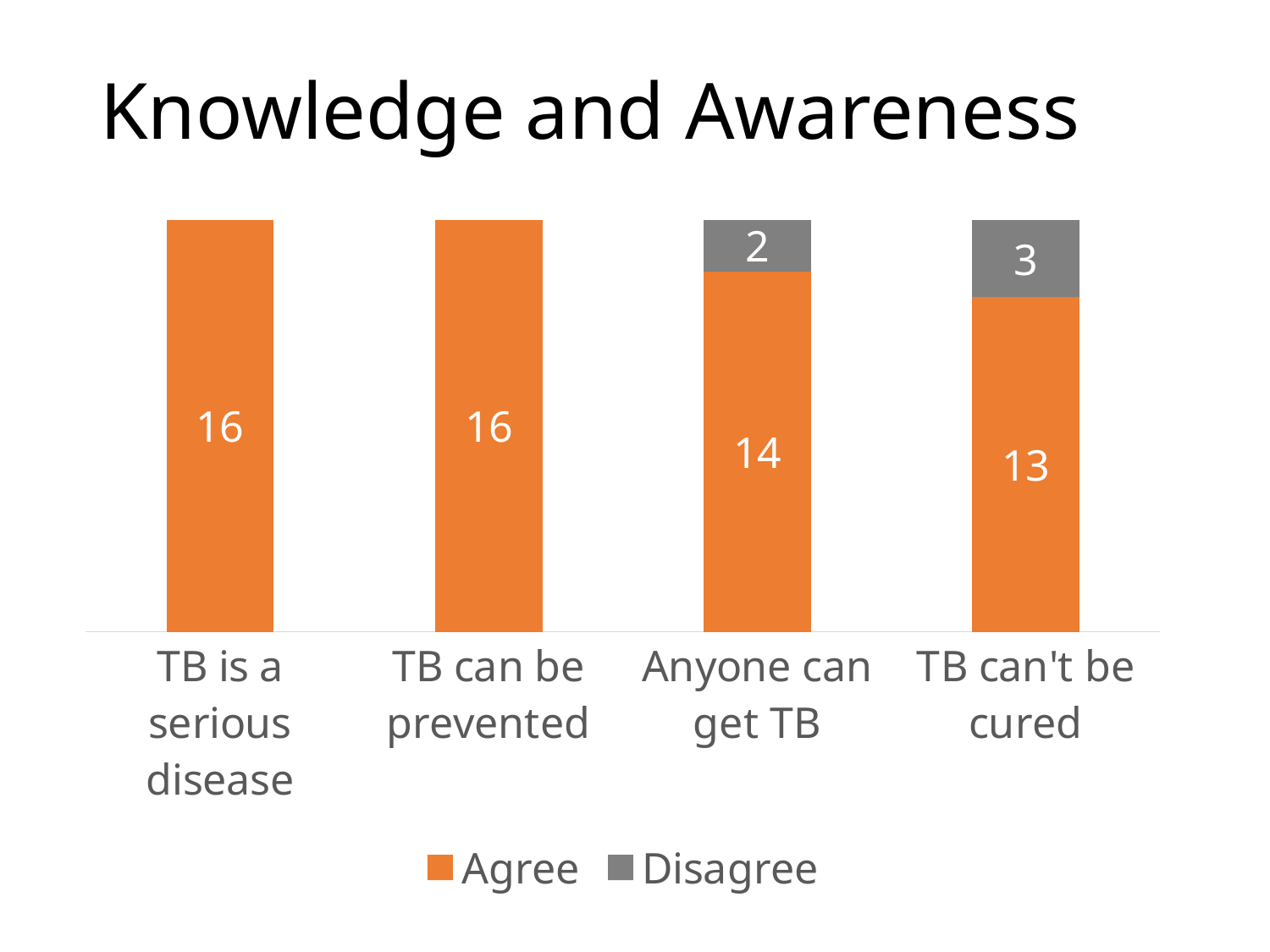
How many series does the legend list? 2 What is the total of the stacked bar for 'TB can't be cured'? 16 What type of chart is shown on the slide? Stacked bar chart What is the total of the stacked bar for 'Anyone can get TB'? 16 What is the difference between the Agree counts for 'TB can be prevented' and 'TB can't be cured'? 3 Which statement has the lowest number of Agree responses? TB can't be cured How many respondents agree that anyone can get TB? 14 How many respondents disagree that TB can't be cured? 3 How many respondents disagree that anyone can get TB? 2 How many statements (categories) are shown on the x axis? 4 How many respondents agree that TB is a serious disease? 16 Which has more Agree responses: 'Anyone can get TB' or 'TB can't be cured'? Anyone can get TB